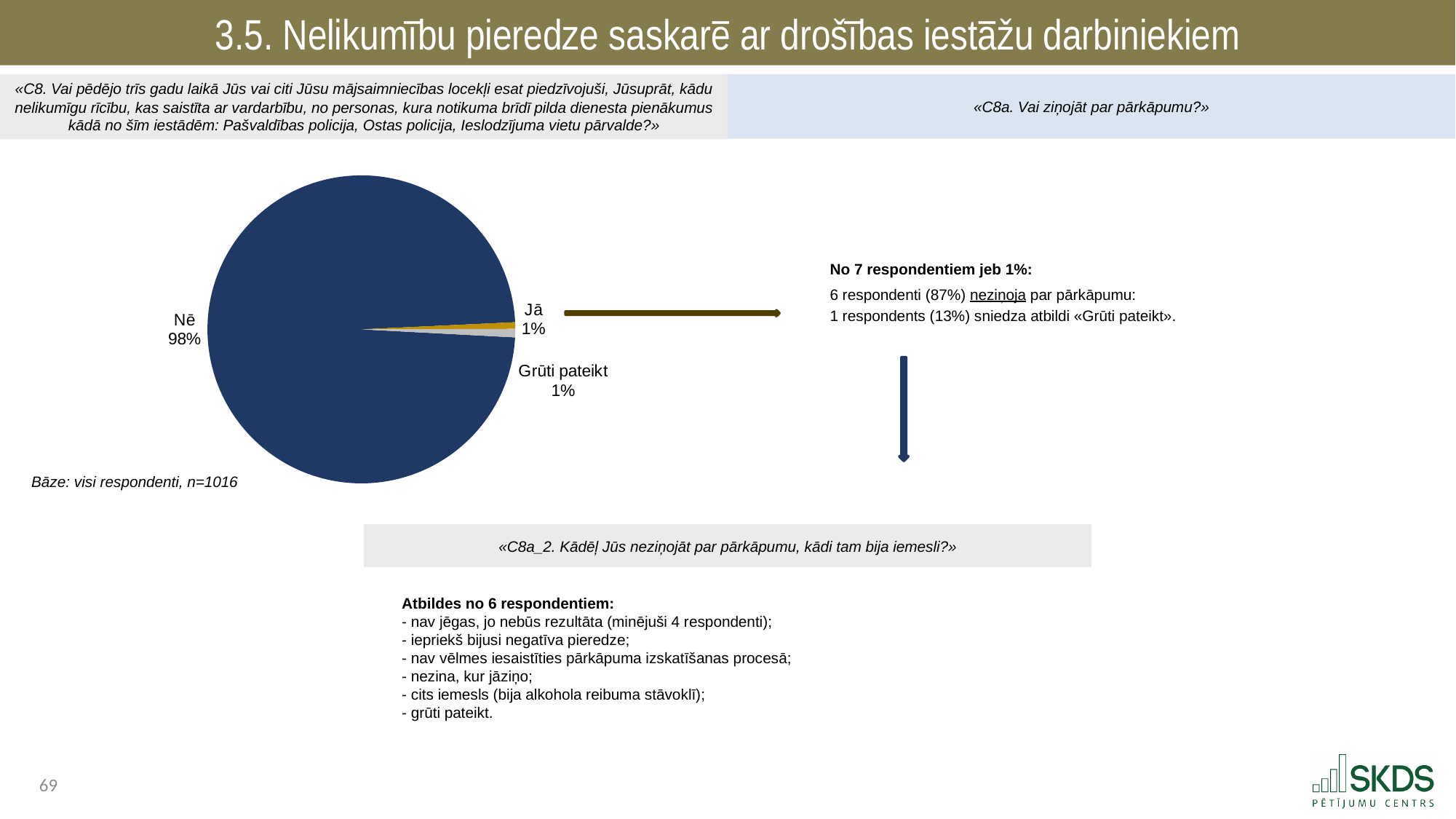
Which slice is larger, "Nē" or "Jā"? Nē What percentage of respondents answered "Jā" in the pie chart? 1% What percentage of respondents answered "Nē" in the pie chart? 98% How many slices (answer categories) does the pie chart have? 3 Which answer category has the largest share of the pie chart? Nē What is the difference in percentage points between the "Nē" and "Jā" slices? 97 percentage points What share of the pie does the "Nē" slice represent? 98% What is the base (number of respondents) stated for the pie chart? n=1016 What type of chart is shown on the slide? Pie chart What percentage of respondents answered "Grūti pateikt" in the pie chart? 1% What colour is the "Nē" slice of the pie chart? Dark blue